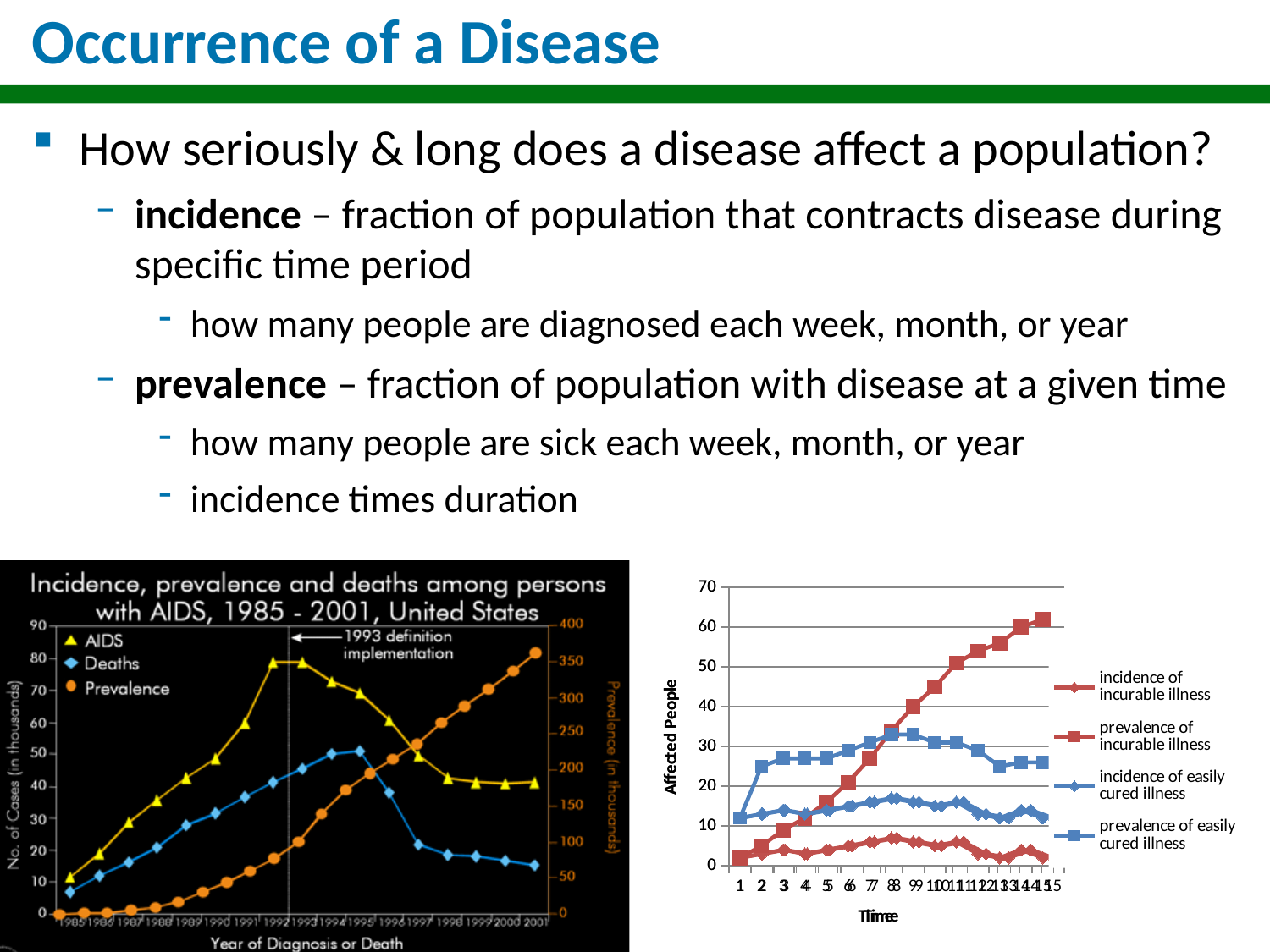
In the right chart, which series reaches the highest value? prevalence of incurable illness What kind of chart is the chart on the left? line chart In the right chart, is the value of prevalence of incurable illness at time 15 greater or less than 50? greater In the left chart, how many series does the legend list? 3 In the right chart, what is the label of the y axis? Affected People In the right chart, is the value of incidence of incurable illness at time 1 greater or less than 10? less In the left chart, is the AIDS value for 1992 greater or less than 70? greater What is the title of the chart on the left? Incidence, prevalence and deaths among persons with AIDS, 1985 - 2001, United States In the left chart, does the Prevalence series rise or fall from 1985 to 2001? rise In the right chart, how many series does the legend list? 4 In the left chart, which is larger in 1997, the AIDS value or the Deaths value? AIDS